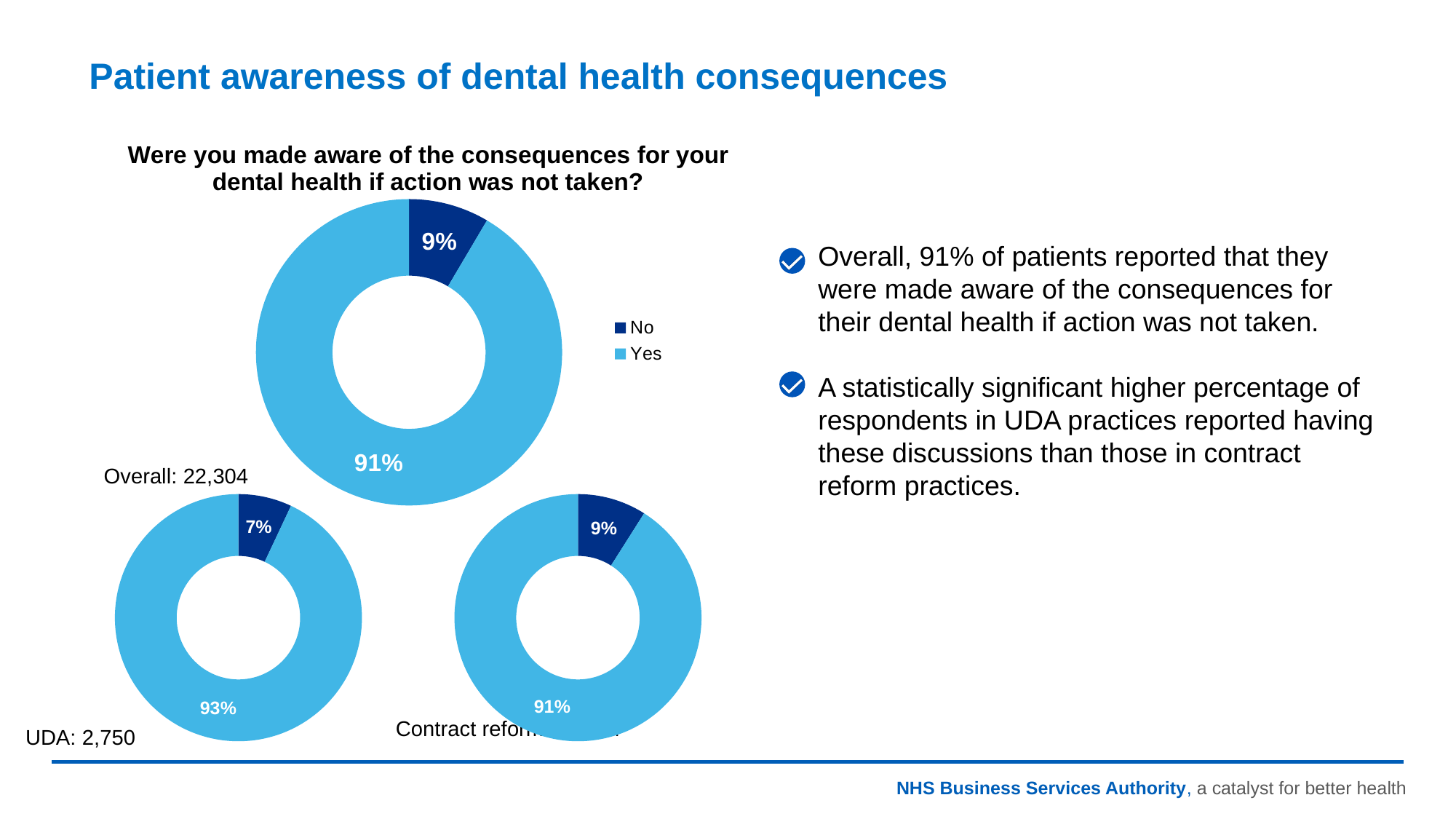
In the large top doughnut chart (Overall), what percentage of patients answered Yes? 91% In the bottom-left doughnut chart (UDA), which category is the smallest? No In the large top doughnut chart (Overall), which category is the largest? Yes What type of chart is used to show the Overall responses? Doughnut chart In the large top doughnut chart (Overall), what percentage of patients answered No? 9% In the bottom-right doughnut chart (Contract reform), what percentage answered No? 9% How many entries does the legend next to the large top chart list? 2 In the bottom-left doughnut chart (UDA), what percentage answered Yes? 93% What is the difference between the Yes percentage in the UDA chart and the Yes percentage in the Contract reform chart? 2% Which chart shows the higher Yes percentage, the bottom-left (UDA) chart or the bottom-right (Contract reform) chart? UDA In the bottom-left doughnut chart (UDA), what percentage answered No? 7% In the bottom-right doughnut chart (Contract reform), what percentage answered Yes? 91%